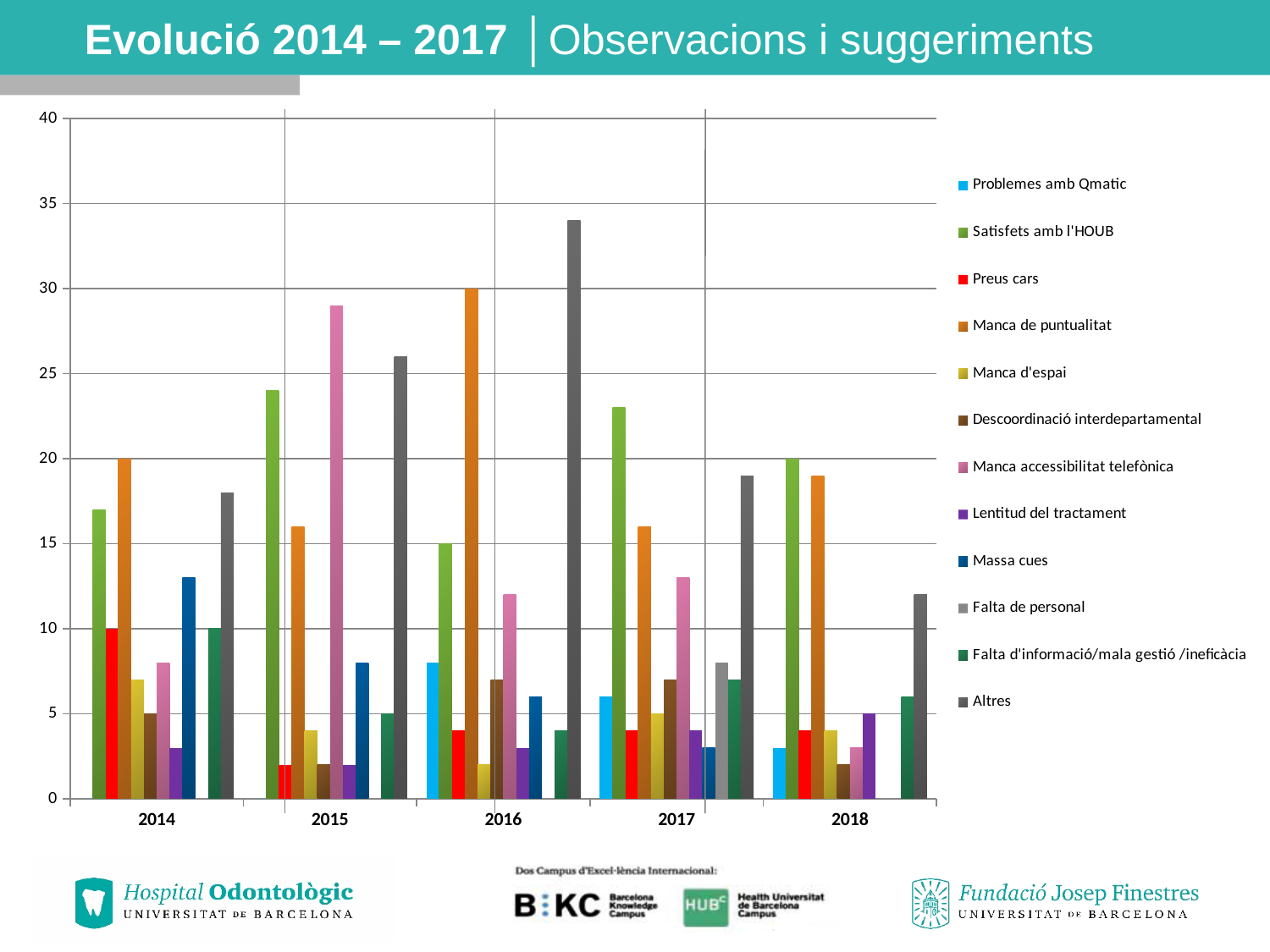
Which series has the highest bar in 2016? Altres What is the value for Manca de puntualitat in 2016? 30 How many year categories are shown on the x axis? 5 How many series does the legend list? 12 Which is larger: Satisfets amb l'HOUB in 2015 or Satisfets amb l'HOUB in 2016? 2015 Which is larger: Manca de puntualitat in 2016 or Manca de puntualitat in 2017? 2016 Is the value for Massa cues in 2014 greater or less than 10? greater Is the value for Satisfets amb l'HOUB in 2015 greater or less than 20? greater Which series has the highest bar in 2015? Manca accessibilitat telefònica Is the value for Altres in 2018 greater or less than 15? less What kind of chart is shown on the slide? bar chart